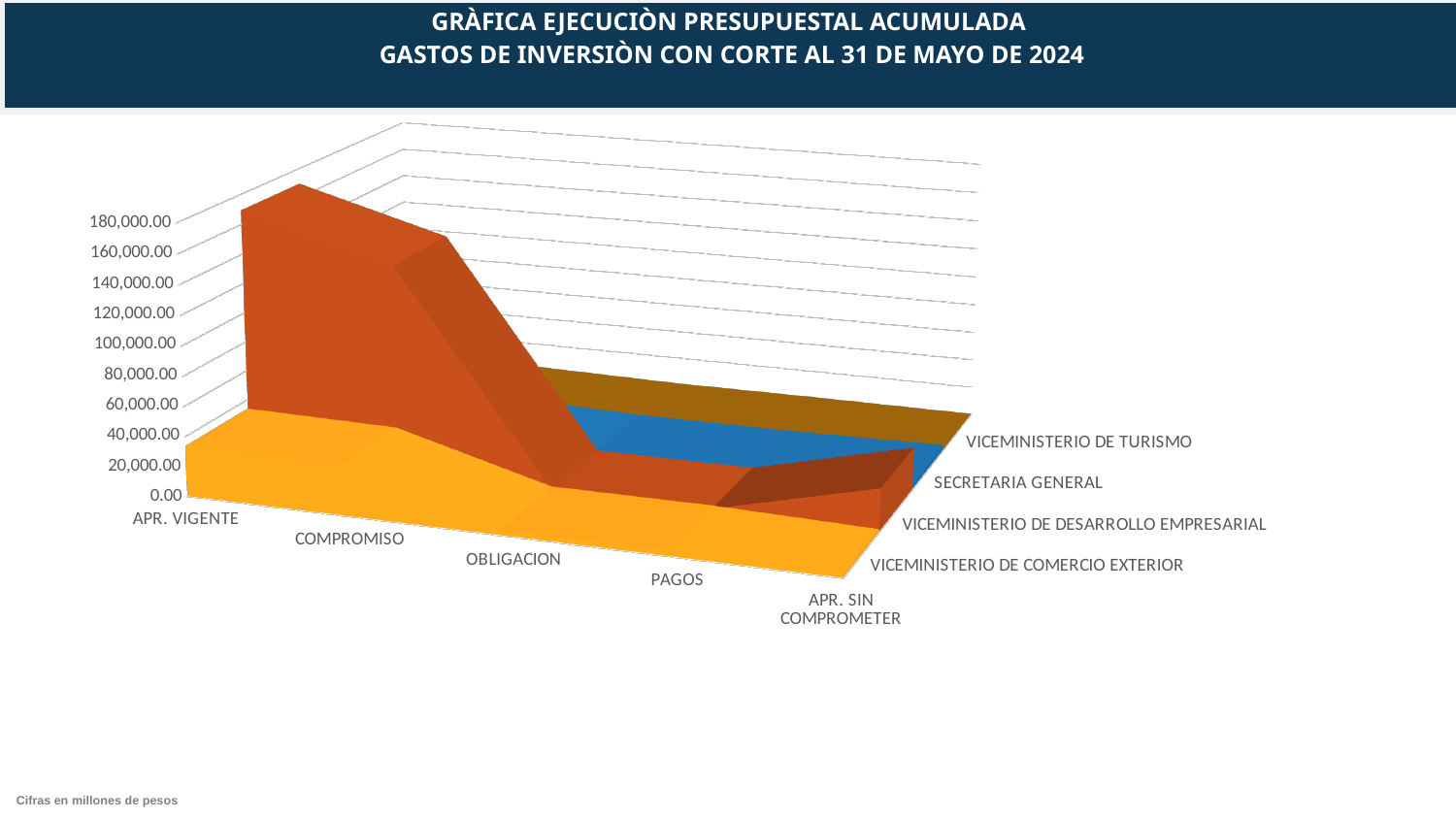
What is the interval between consecutive tick marks on the vertical axis? 20,000.00 What is the first category on the front horizontal axis of the chart? APR. VIGENTE Which entity is listed at the front of the depth axis of the chart? VICEMINISTERIO DE COMERCIO EXTERIOR What is the lowest tick value shown on the vertical axis of the chart? 0.00 Which entity is listed furthest back on the depth axis of the chart? VICEMINISTERIO DE TURISMO What is the highest tick value shown on the vertical axis of the chart? 180,000.00 How many entities (series) are listed along the depth axis of the chart? 4 What kind of chart is shown on the slide? 3D area chart According to the note at the bottom of the slide, in what units are the figures expressed? Millones de pesos How many categories are shown along the front horizontal axis of the chart? 5 What cut-off date is stated in the chart title? 31 de mayo de 2024 What is the last category on the front horizontal axis of the chart? APR. SIN COMPROMETER